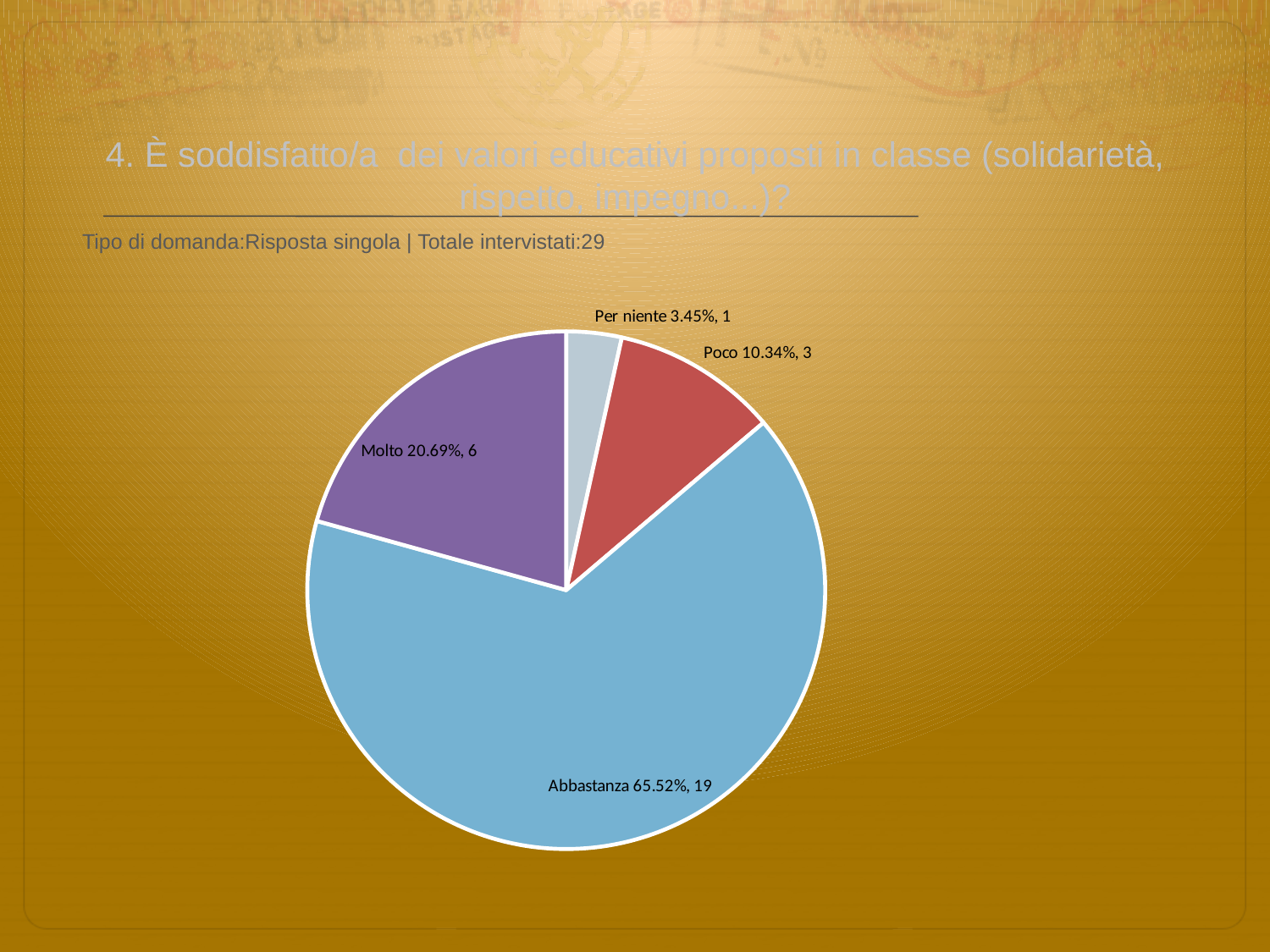
What colour is the Abbastanza slice? blue How many respondents answered Poco? 3 What percentage share does the Per niente slice have? 3.45% Which category has the largest slice? Abbastanza What kind of chart is shown on the slide? pie chart What is the total number of respondents across all slices? 29 What is the difference in respondent count between Abbastanza and Molto? 13 How many slices does the pie chart have? 4 Which has more respondents, Molto or Poco? Molto What percentage share does the Abbastanza slice have? 65.52% Which category has the smallest slice? Per niente How many respondents answered Molto? 6